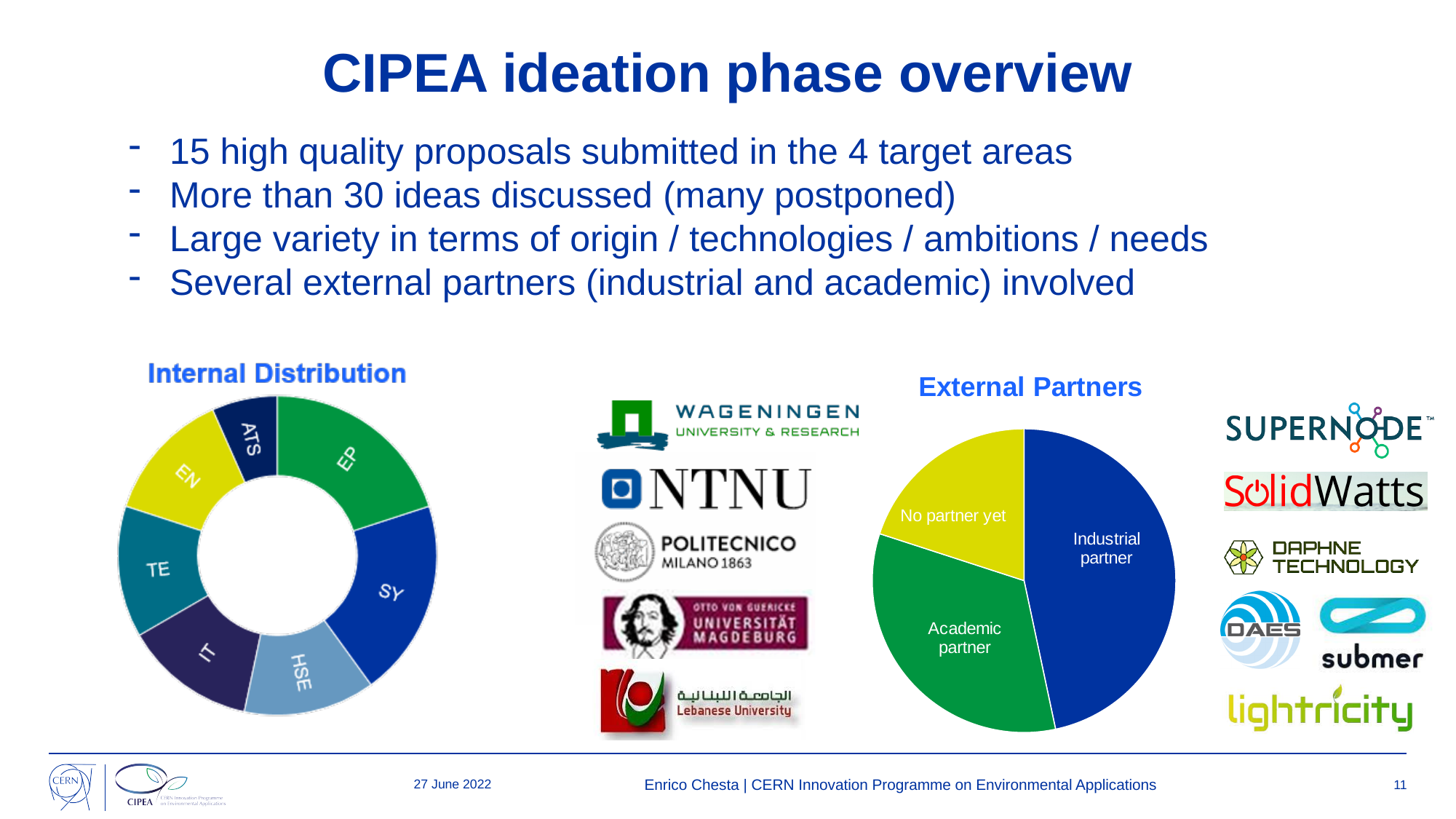
In the Internal Distribution chart, which segment is larger: SY or ATS? SY In the External Partners chart, which category has the smallest slice? No partner yet In the Internal Distribution chart, which category has the smallest segment? ATS How many slices does the External Partners pie chart have? 3 In the External Partners chart, what colour is the Academic partner slice? Green How many categories are shown in the Internal Distribution chart? 7 What kind of chart is the External Partners chart? Pie chart What kind of chart is the Internal Distribution chart? Donut chart In the External Partners chart, which slice is larger: Academic partner or No partner yet? Academic partner In the External Partners chart, which category has the largest slice? Industrial partner In the Internal Distribution chart, which segment is larger: EP or HSE? EP What is the title of the chart on the left of the slide? Internal Distribution